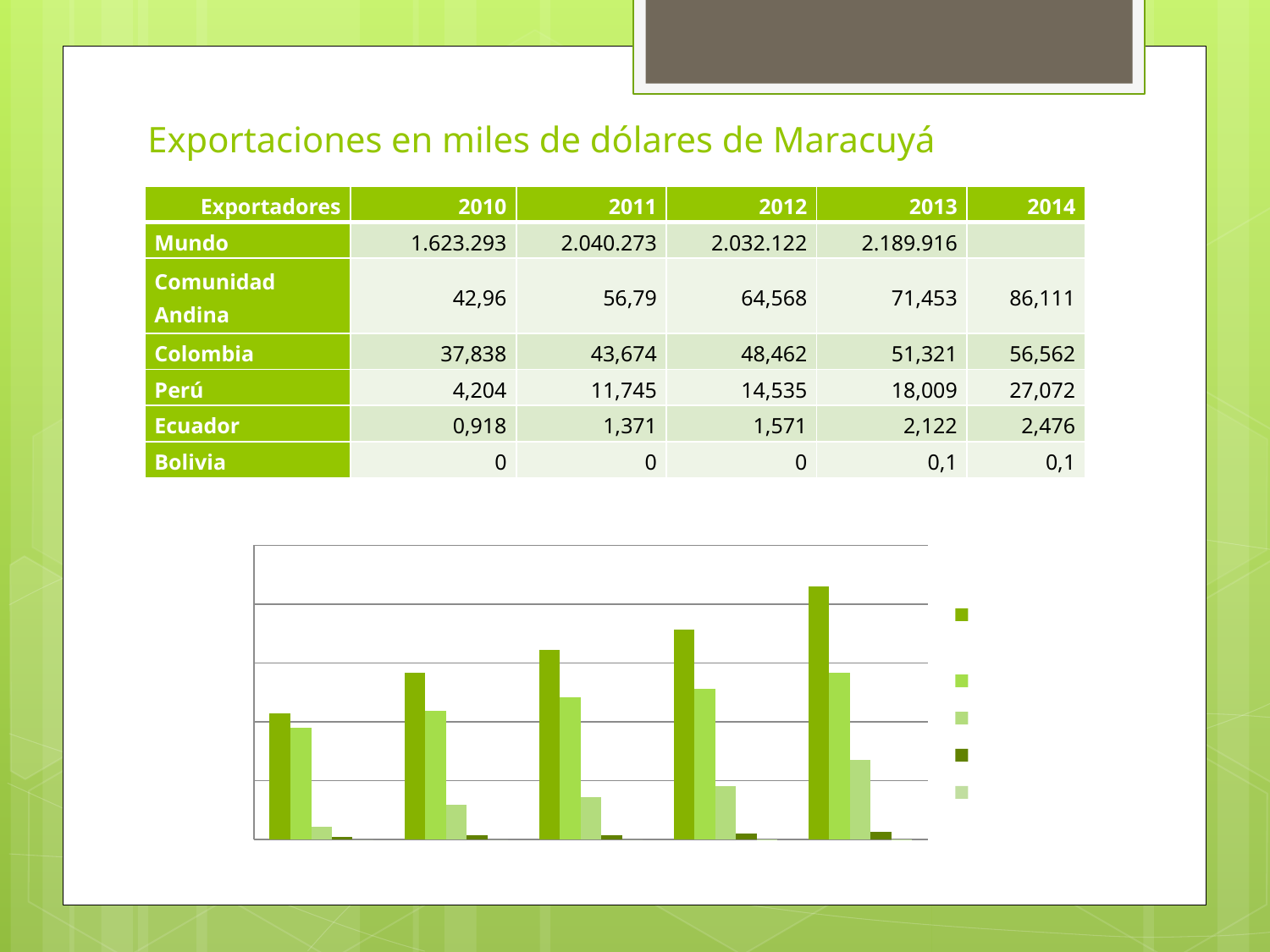
Does the chart's legend show text labels next to its colour markers? No Does the chart display a title above the plot area? No How many groups of bars are plotted along the x axis of the chart? 5 How many series does the chart's legend list? 5 Do the tallest bars in each group rise or fall from left to right across the chart? rise Do the second-tallest (light green) bars in each group rise or fall from left to right across the chart? rise What kind of chart is shown at the bottom of the slide? bar chart In the chart, which group of bars has the tallest bar: the leftmost group or the rightmost group? the rightmost group